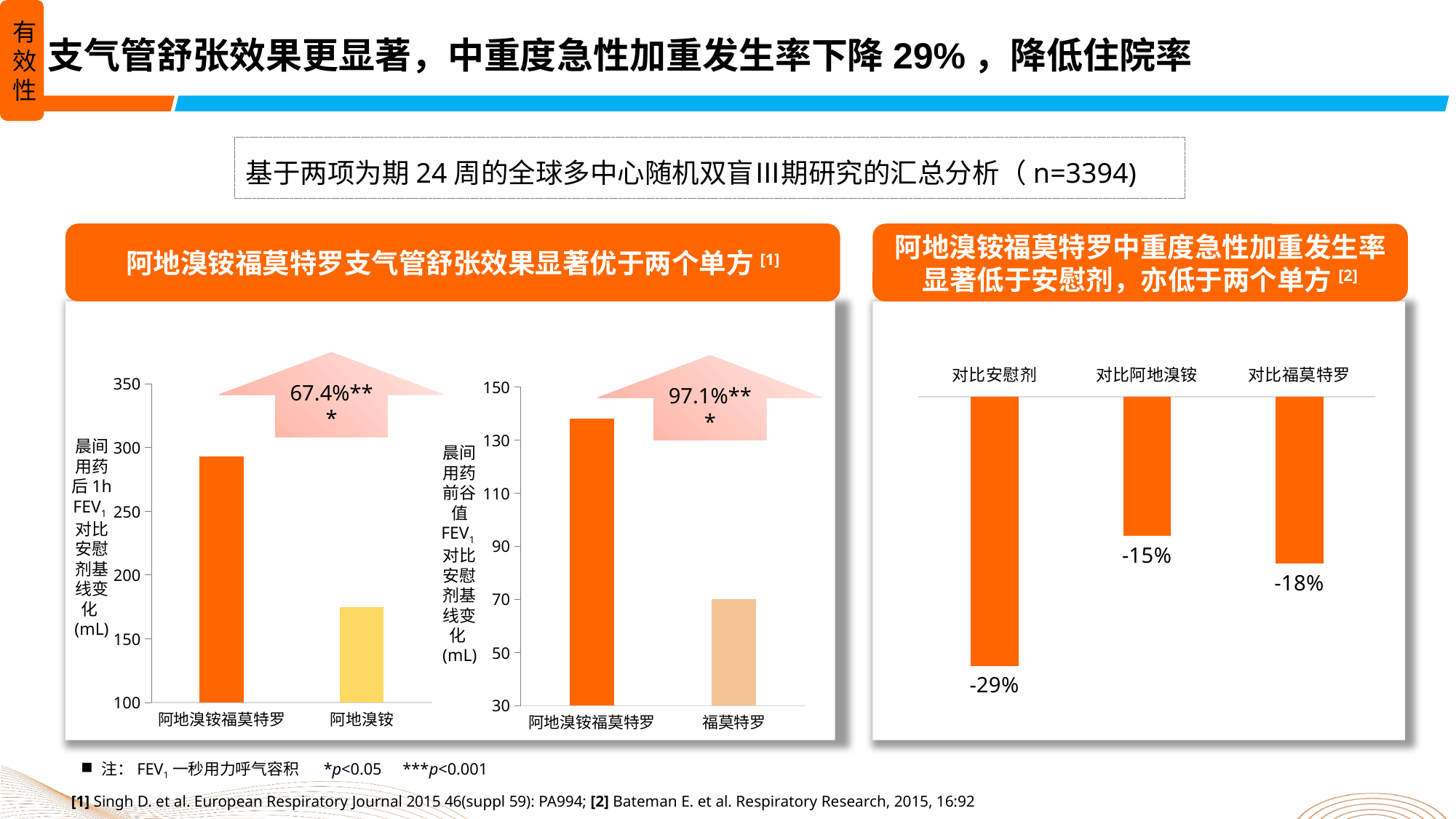
In the middle chart (晨间用药前谷值 FEV1), which bar is taller, 阿地溴铵福莫特罗 or 福莫特罗? 阿地溴铵福莫特罗 In the middle chart (晨间用药前谷值 FEV1), is the value for 阿地溴铵福莫特罗 greater or less than 130? greater What type of chart is used in the left-most panel comparing 阿地溴铵福莫特罗 and 阿地溴铵? Bar chart In the right-hand chart (阿地溴铵福莫特罗中重度急性加重发生率), what is the value shown for 对比安慰剂? -29% In the right-hand chart, which comparison shows the largest reduction in exacerbation rate? 对比安慰剂 In the right-hand chart, which comparison shows the smallest reduction in exacerbation rate? 对比阿地溴铵 In the right-hand chart, what is the value shown for 对比福莫特罗? -18% How many bars are plotted in the right-hand chart? 3 In the left-most chart (晨间用药后1h FEV1), is the value for 阿地溴铵福莫特罗 greater or less than 250? greater In the right-hand chart, what is the value shown for 对比阿地溴铵? -15% In the right-hand chart, how many percentage points larger is the reduction for 对比安慰剂 than for 对比阿地溴铵? 14 In the left-most chart (晨间用药后1h FEV1), is the value for 阿地溴铵 greater or less than 200? less